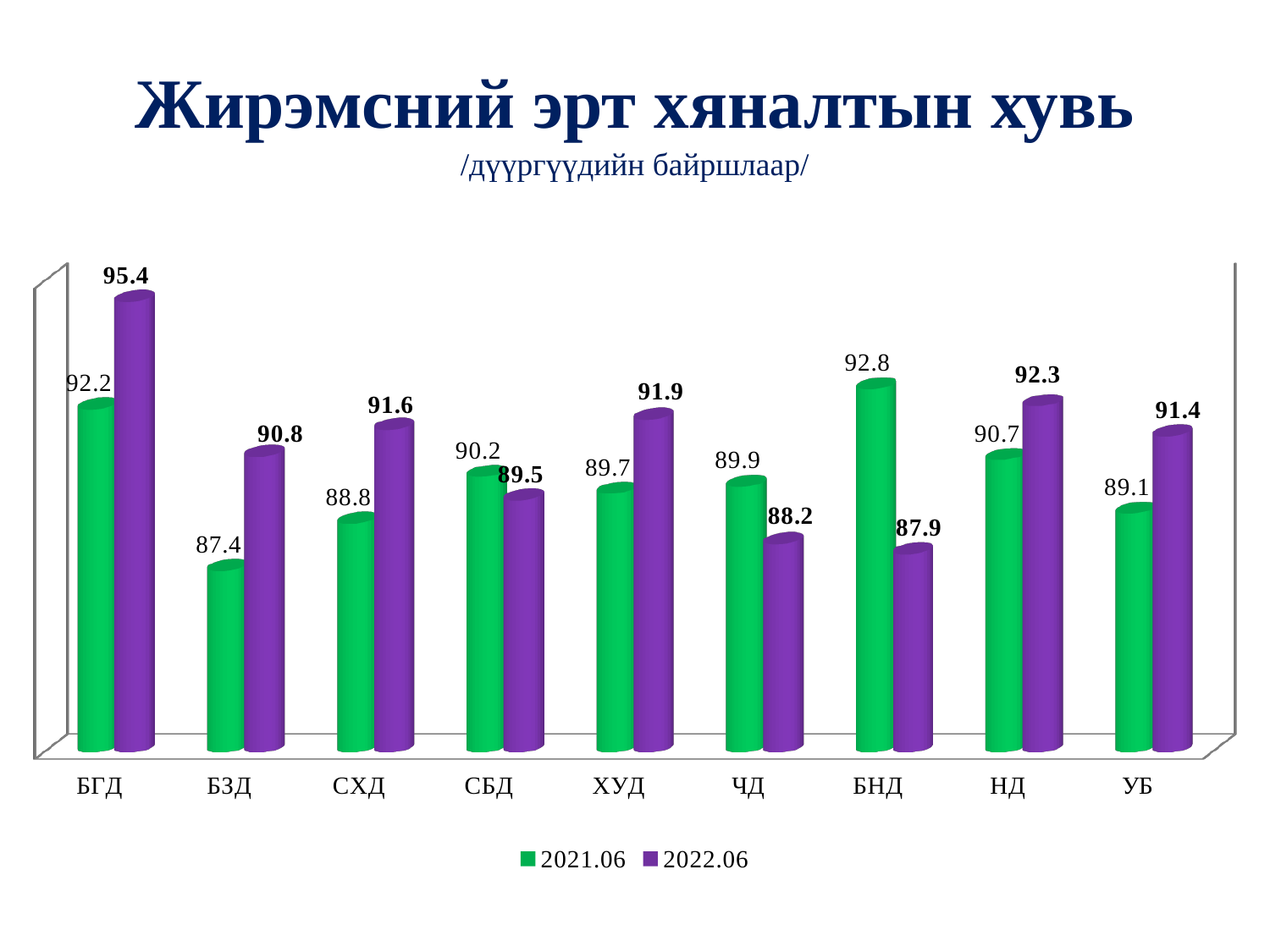
What is the value for БГД in the 2022.06 series? 95.4 How many series does the legend list? 2 Which category has the lowest value in the 2021.06 series? БЗД What is the value for БНД in the 2021.06 series? 92.8 What is the value for ЧД in the 2022.06 series? 88.2 Which category has the highest value in the 2022.06 series? БГД Which is larger for СБД: the 2021.06 value or the 2022.06 value? 2021.06 What is the title of the chart on the slide? Жирэмсний эрт хяналтын хувь What is the difference between the 2022.06 and 2021.06 values for БЗД? 3.4 How many categories are shown on the x axis? 9 What kind of chart is shown on the slide? Bar chart Which category has the lowest value in the 2022.06 series? БНД